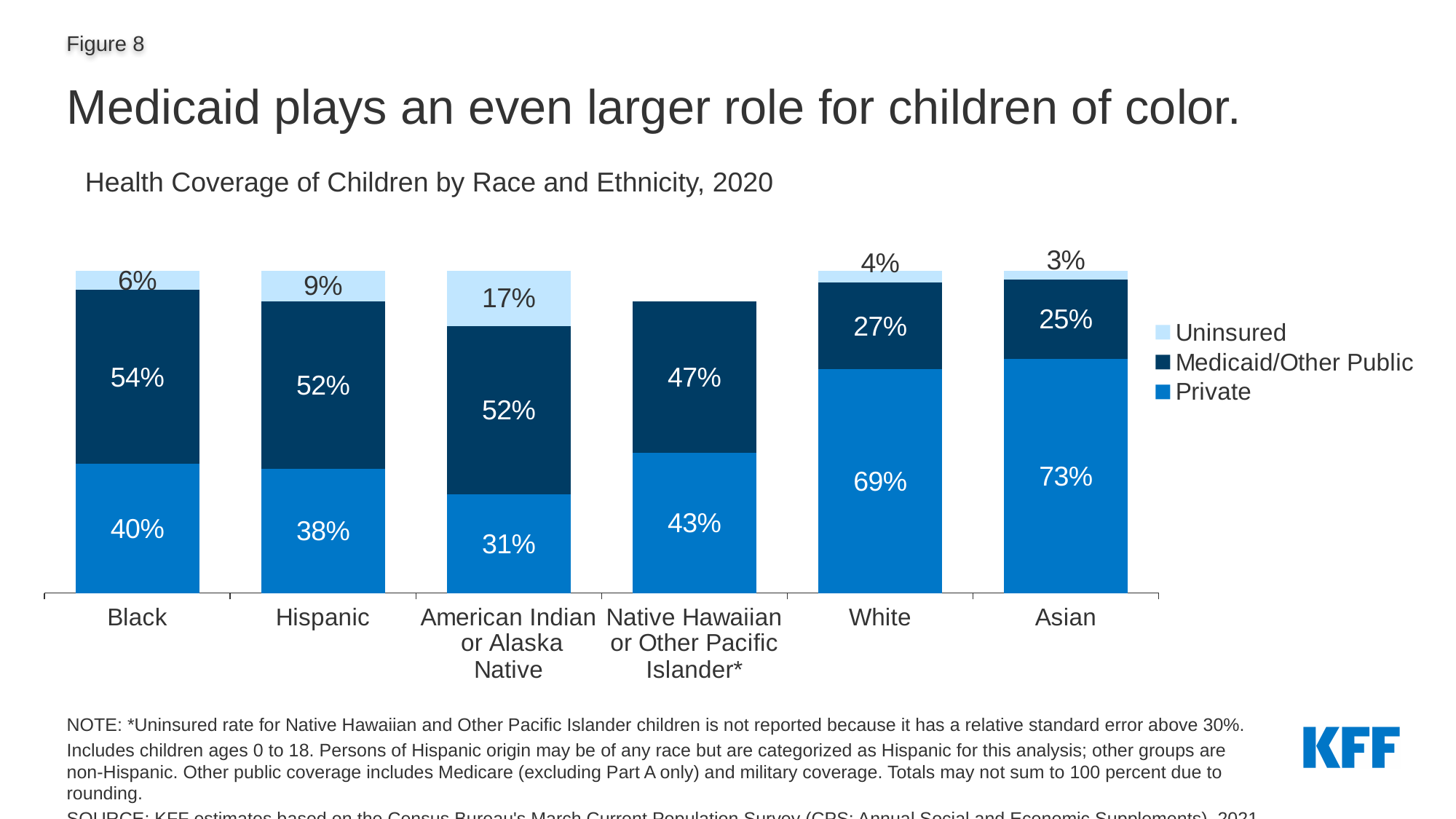
How many race and ethnicity groups are shown on the x axis? 6 What kind of chart is shown on the slide? Stacked bar chart How many series does the legend list? 3 What is the difference between the Private coverage share for Asian children and for Black children? 33 percentage points Which group has the highest Private coverage share? Asian Which group has a larger Medicaid/Other Public share, Black or Hispanic? Black What is the Uninsured share for Hispanic children? 9% Which group has the lowest Private coverage share? American Indian or Alaska Native What is the subtitle of the chart? Health Coverage of Children by Race and Ethnicity, 2020 Which group has the highest Uninsured share? American Indian or Alaska Native What is the Medicaid/Other Public share for American Indian or Alaska Native children? 52% What is the Private coverage share for White children? 69%